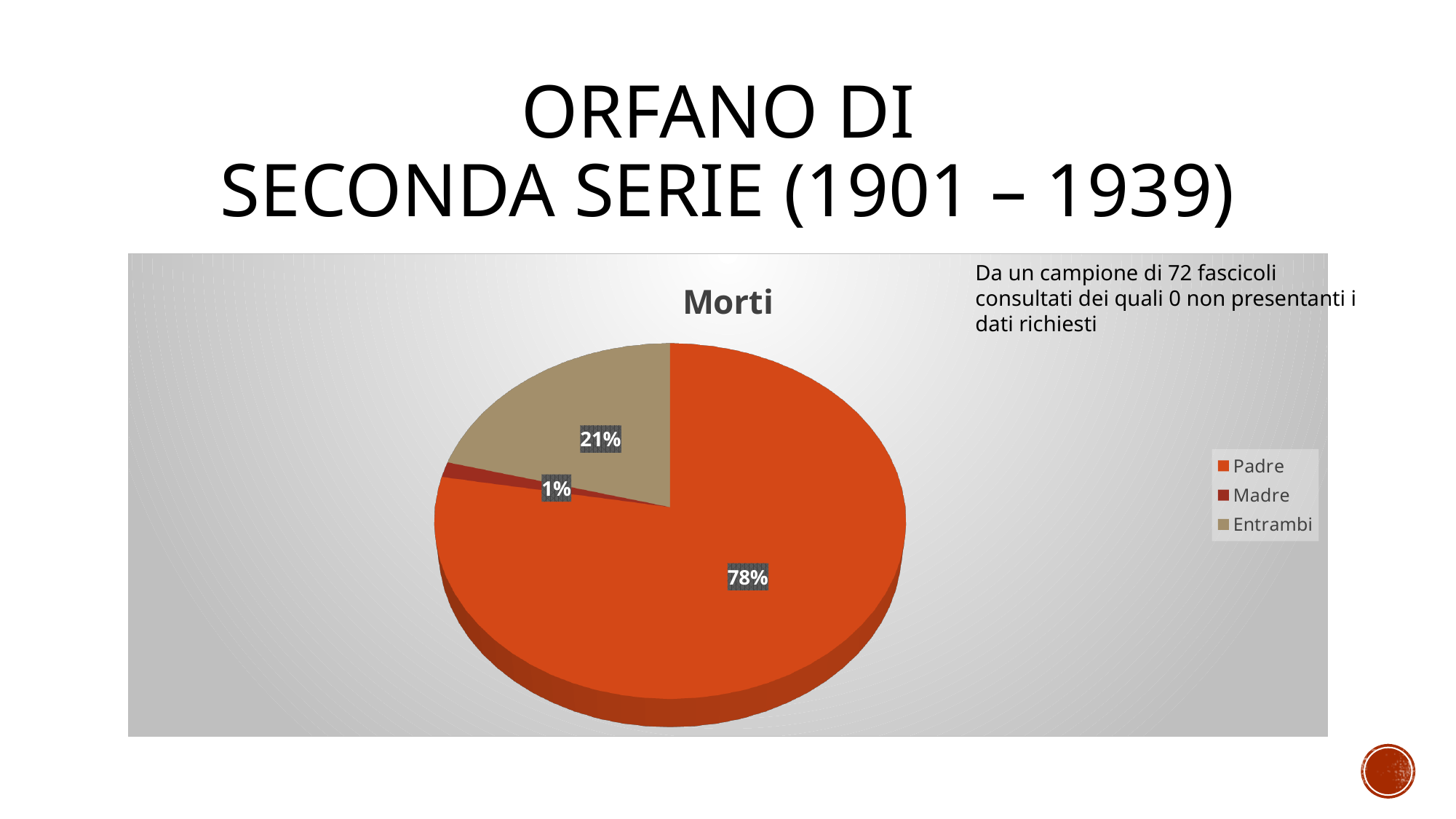
What colour is the Padre slice? Orange-red Which category has the smallest share of the pie? Madre What percentage of the pie is labelled Madre? 1% What is the difference in percentage points between the Padre and Entrambi slices? 57 What is the combined share of the Madre and Entrambi slices? 22% What type of chart is shown on the slide? Pie chart What is the title of the chart? Morti What percentage of the pie is labelled Padre? 78% Which slice is larger, Entrambi or Madre? Entrambi What percentage of the pie is labelled Entrambi? 21% Which category has the largest share of the pie? Padre How many categories does the legend list? 3